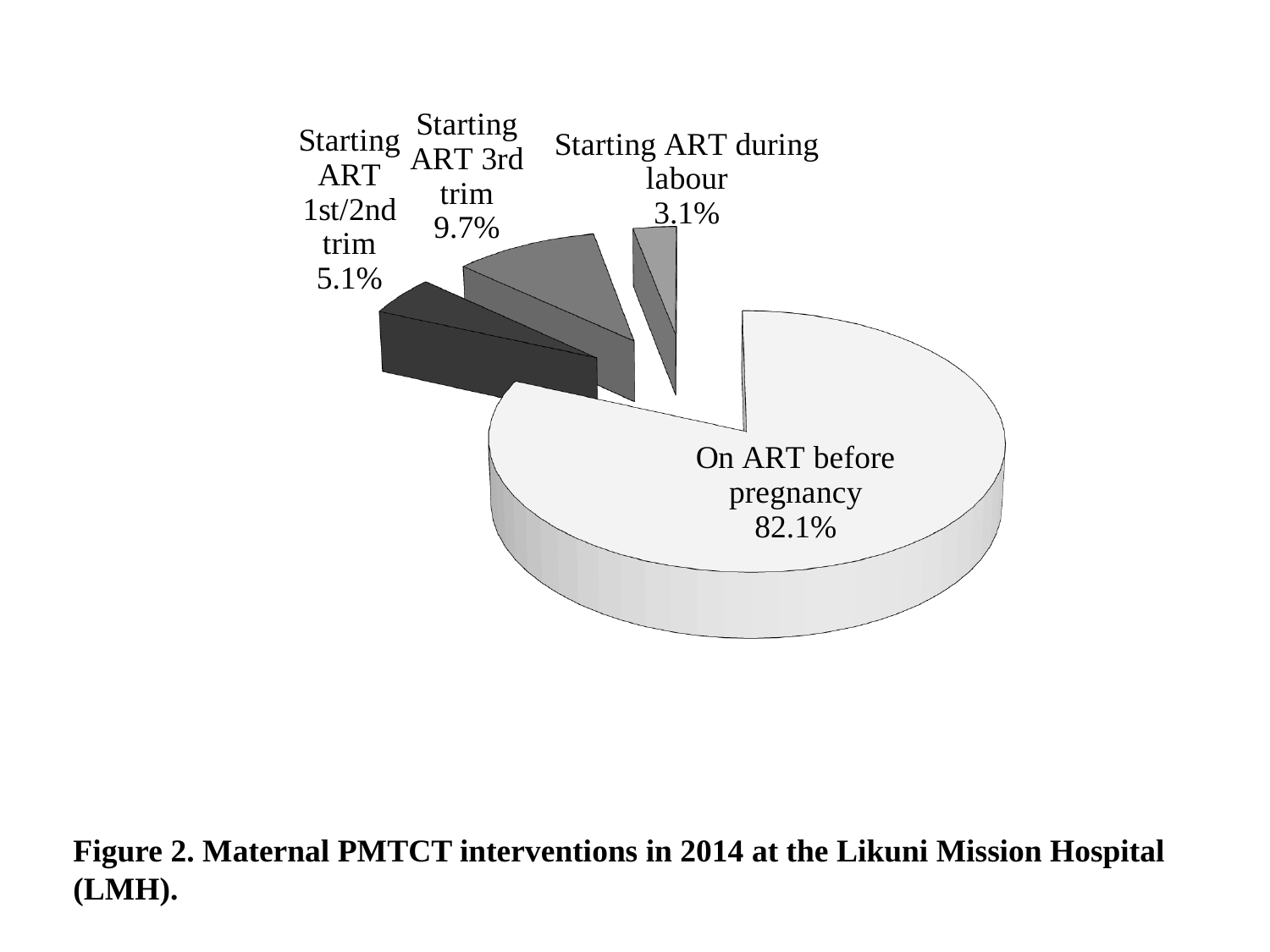
Which is larger: 'Starting ART 1st/2nd trim' or 'Starting ART during labour'? Starting ART 1st/2nd trim What share of the pie is 'On ART before pregnancy'? 82.1% What is the figure caption below the chart? Figure 2. Maternal PMTCT interventions in 2014 at the Likuni Mission Hospital (LMH). What is the difference in percentage points between 'On ART before pregnancy' and 'Starting ART 3rd trim'? 72.4 Which category has the largest slice of the pie? On ART before pregnancy What kind of chart is shown on the slide? Pie chart What is the difference in percentage points between 'Starting ART 3rd trim' and 'Starting ART 1st/2nd trim'? 4.6 Which category has the smallest slice of the pie? Starting ART during labour What share of the pie is 'Starting ART during labour'? 3.1% What share of the pie is 'Starting ART 3rd trim'? 9.7% How many slices does the pie chart have? 4